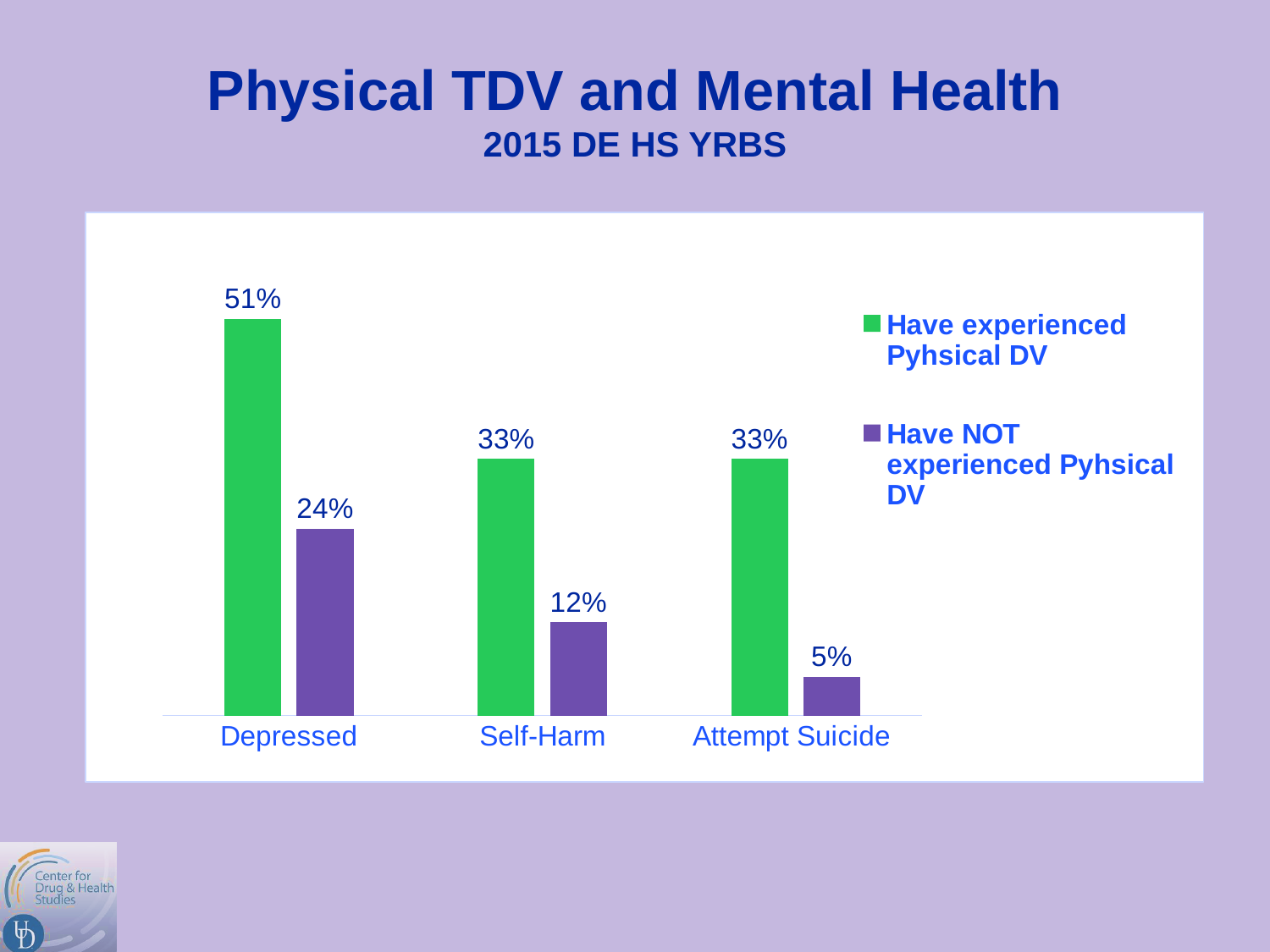
How many categories are shown on the x axis? 3 How many series does the legend list? 2 What percentage of students who have NOT experienced physical DV reported attempting suicide? 5% What is the difference between the two series for the Depressed category? 27% What is the difference between the two series for the Attempt Suicide category? 28% What is the value for Self-Harm among students who have NOT experienced physical DV? 12% What colour are the bars for students who have NOT experienced physical DV? Purple For Self-Harm, which group has the larger value: those who have experienced physical DV or those who have not? Have experienced Pyhsical DV What percentage of students who have experienced physical DV reported being depressed? 51% What kind of chart is shown on the slide? Bar chart Which category has the highest value for students who have experienced physical DV? Depressed Which category has the lowest value for students who have NOT experienced physical DV? Attempt Suicide